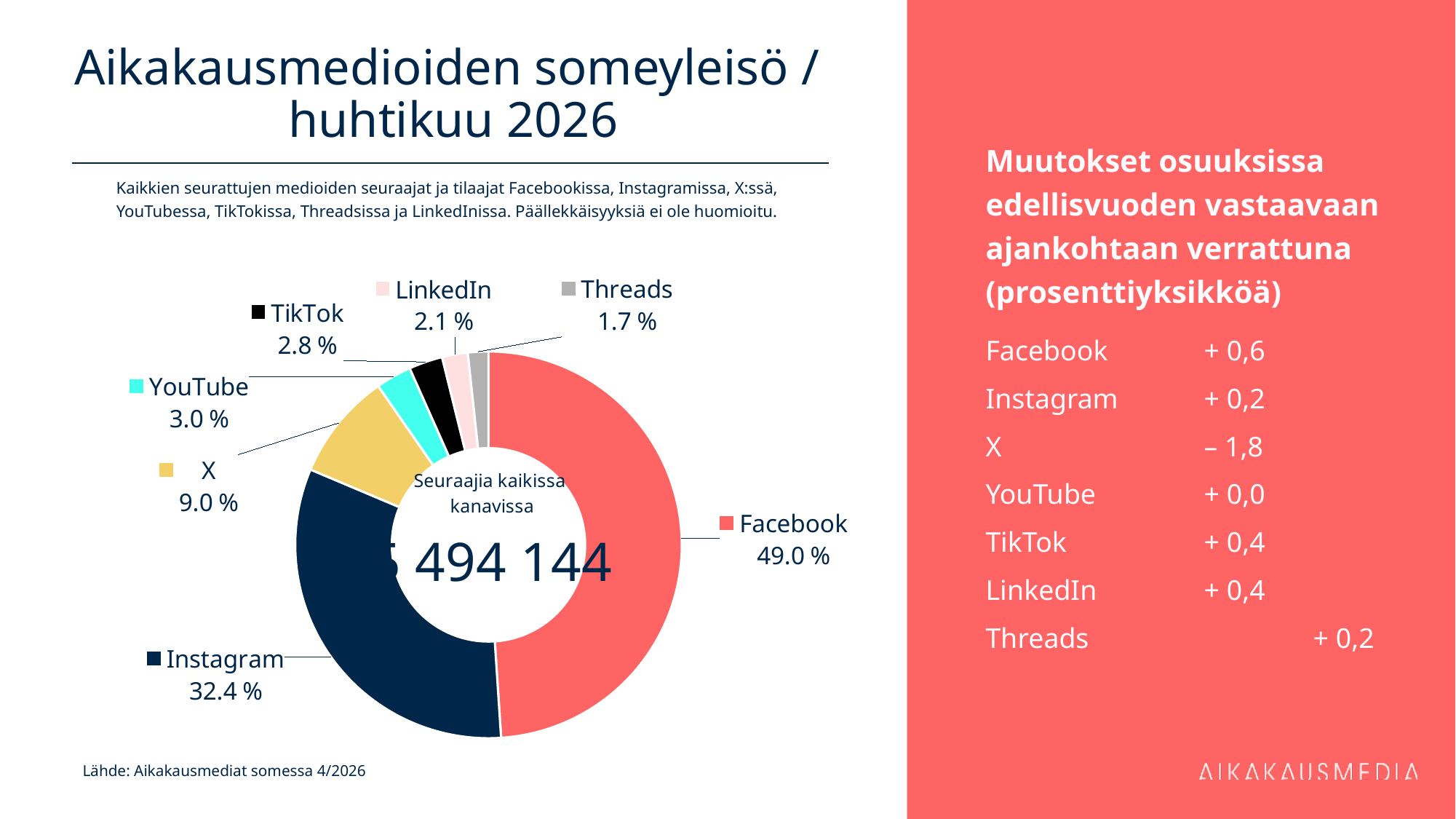
How many platforms (slices) are shown in the donut chart? 7 What colour is the Facebook slice in the donut chart? Red (coral) Which platform has the largest share in the donut chart? Facebook What is the share shown for X in the donut chart? 9.0 % What is the difference in percentage points between Facebook's and Instagram's shares? 16.6 What share of the donut chart does Instagram hold? 32.4 % What is the combined share of LinkedIn and Threads in the donut chart? 3.8 % What type of chart is shown on the slide? Donut (pie) chart What share of the donut chart does Facebook hold? 49.0 % What is the share shown for Threads in the donut chart? 1.7 % Which platform has the smallest share in the donut chart? Threads Which has a larger share in the donut chart, YouTube or TikTok? YouTube